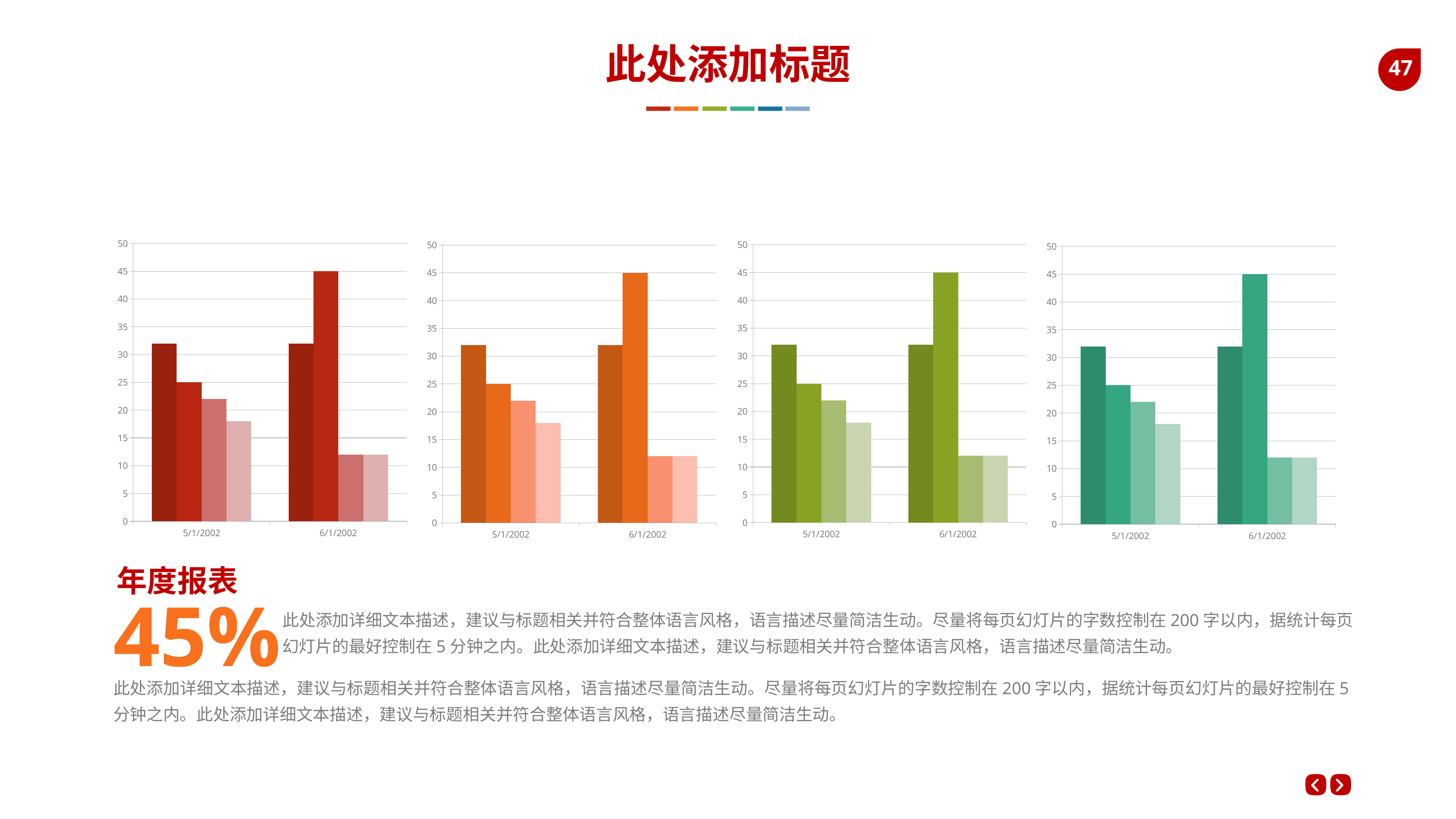
In the third chart from the left (green), is the value of the third bar in the 5/1/2002 group greater or less than 20? greater In the leftmost (red) chart, which is larger: the third bar in the 5/1/2002 group or the third bar in the 6/1/2002 group? the third bar in the 5/1/2002 group In the third chart from the left (green), what is the value of the second bar from the left in the 5/1/2002 group? 25 In the rightmost (teal) chart, what are the two category labels on the x axis? 5/1/2002 and 6/1/2002 In the rightmost (teal) chart, what is the highest value shown on the vertical axis? 50 In the leftmost (red) chart, which category contains the tallest bar? 6/1/2002 What kind of chart is the leftmost (red) chart on the slide? bar chart How many charts are shown on the slide? 4 In the second chart from the left (orange), is the value of the last bar in the 6/1/2002 group greater or less than 15? less In the second chart from the left (orange), what is the value of the tallest bar in the 6/1/2002 group? 45 In the leftmost (red) chart, how many categories are shown on the x axis? 2 In the rightmost (teal) chart, is the value of the first bar in the 5/1/2002 group greater or less than 30? greater